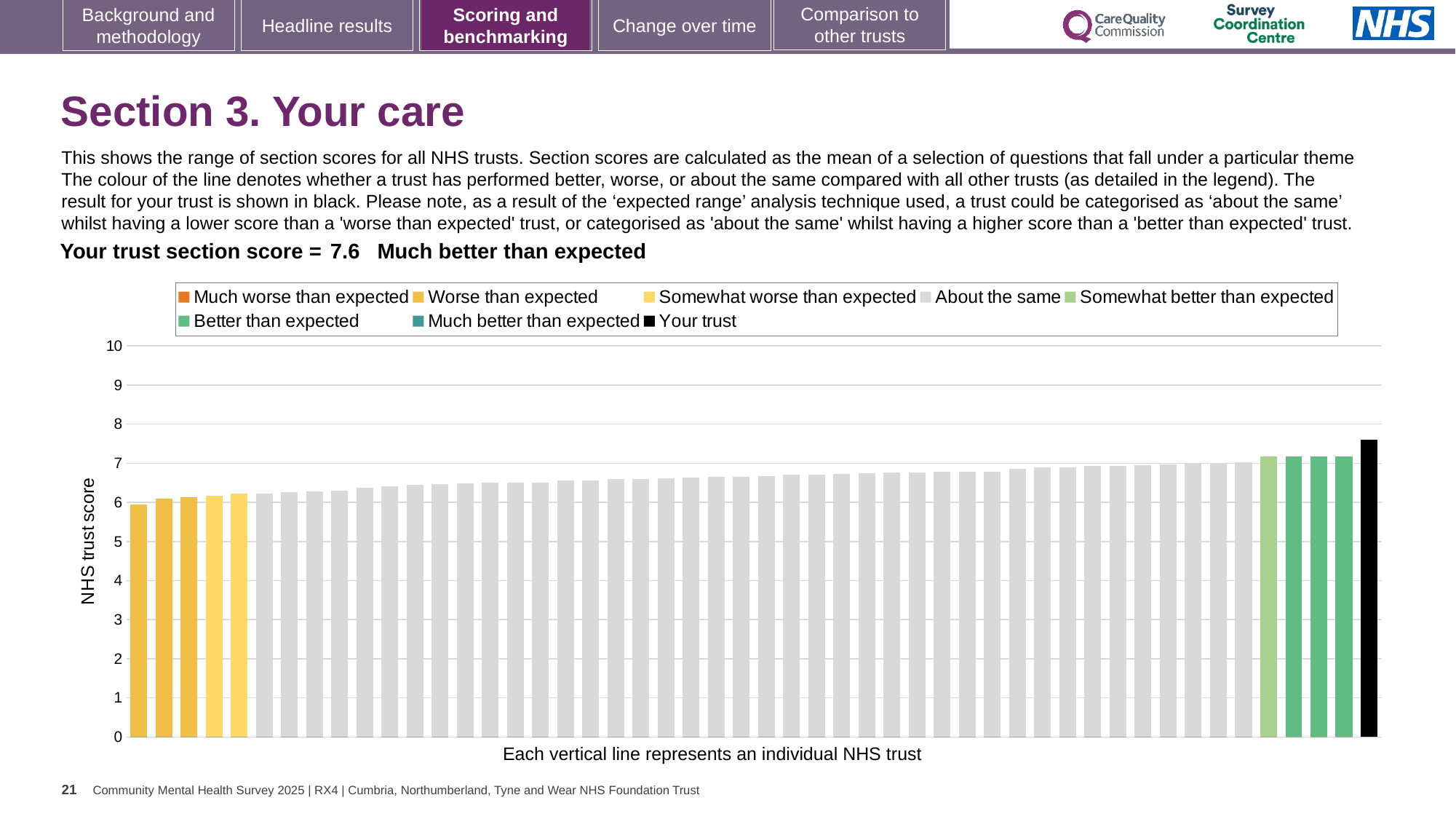
Do the bar values rise or fall from left to right along the x axis? Rise Which bar in the chart is the highest? Your trust (the black bar) Is the value for the leftmost bar greater or less than 7? less What kind of chart is shown on the slide? Bar chart What is the label on the y axis of the chart? NHS trust score What is the section score for your trust shown on the slide? 7.6 What category does the black colour represent in the legend? Your trust Is the value for the leftmost bar greater or less than 5? greater How many entries does the chart legend list? 8 Is the value for the black 'Your trust' bar greater or less than 7? greater Which is larger: the value for the black 'Your trust' bar or the value for the leftmost bar? Your trust